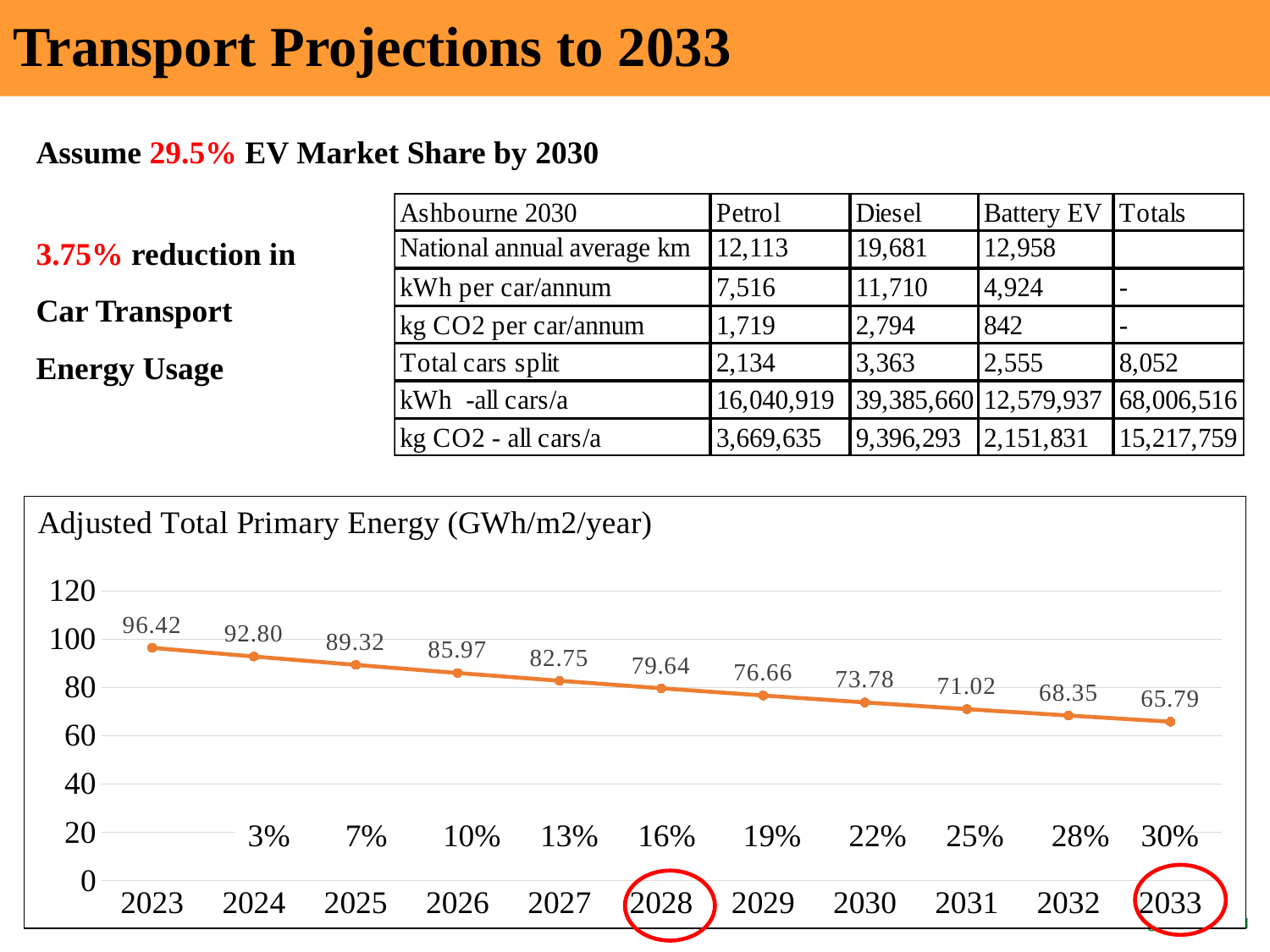
What is the Adjusted Total Primary Energy value for 2033? 65.79 What is the Adjusted Total Primary Energy value for 2030? 73.78 Which year has the highest Adjusted Total Primary Energy value? 2023 What type of chart is shown under the title "Adjusted Total Primary Energy (GWh/m2/year)"? line chart Which is larger, the Adjusted Total Primary Energy value for 2025 or for 2031? 2025 What is the Adjusted Total Primary Energy value for 2028? 79.64 Do the Adjusted Total Primary Energy values rise or fall from 2023 to 2033? fall What is the Adjusted Total Primary Energy value for 2023? 96.42 Is the Adjusted Total Primary Energy value for 2027 greater or less than 80? greater What is the difference between the Adjusted Total Primary Energy values for 2023 and 2033? 30.63 How many years are plotted on the Adjusted Total Primary Energy chart? 11 Which year has the lowest Adjusted Total Primary Energy value? 2033